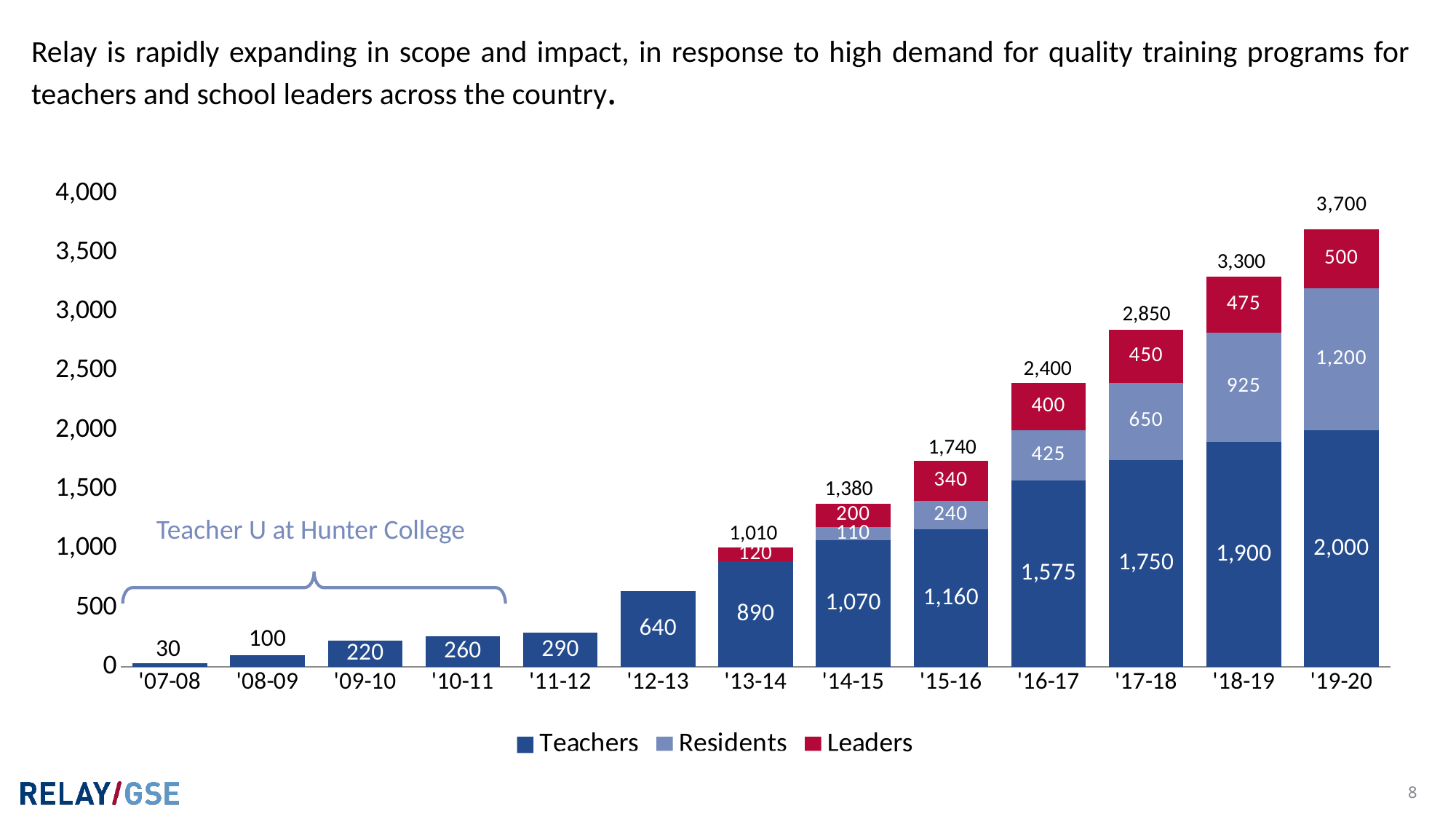
Do the totals rise or fall from '07-08 to '19-20? Rise Which year has the lowest total? '07-08 What is the difference between the Teachers value in '19-20 and the Teachers value in '18-19? 100 Which year has the highest total? '19-20 In '16-17, which is larger, the Residents value or the Leaders value? Residents What is the value for Residents in '18-19? 925 What is the value for Leaders in '15-16? 340 What kind of chart is shown on the slide? Stacked bar chart What is the value for Teachers in '16-17? 1,575 How many series does the legend list? 3 What is the total of the stacked bar for '19-20? 3,700 How many years are shown on the x axis? 13